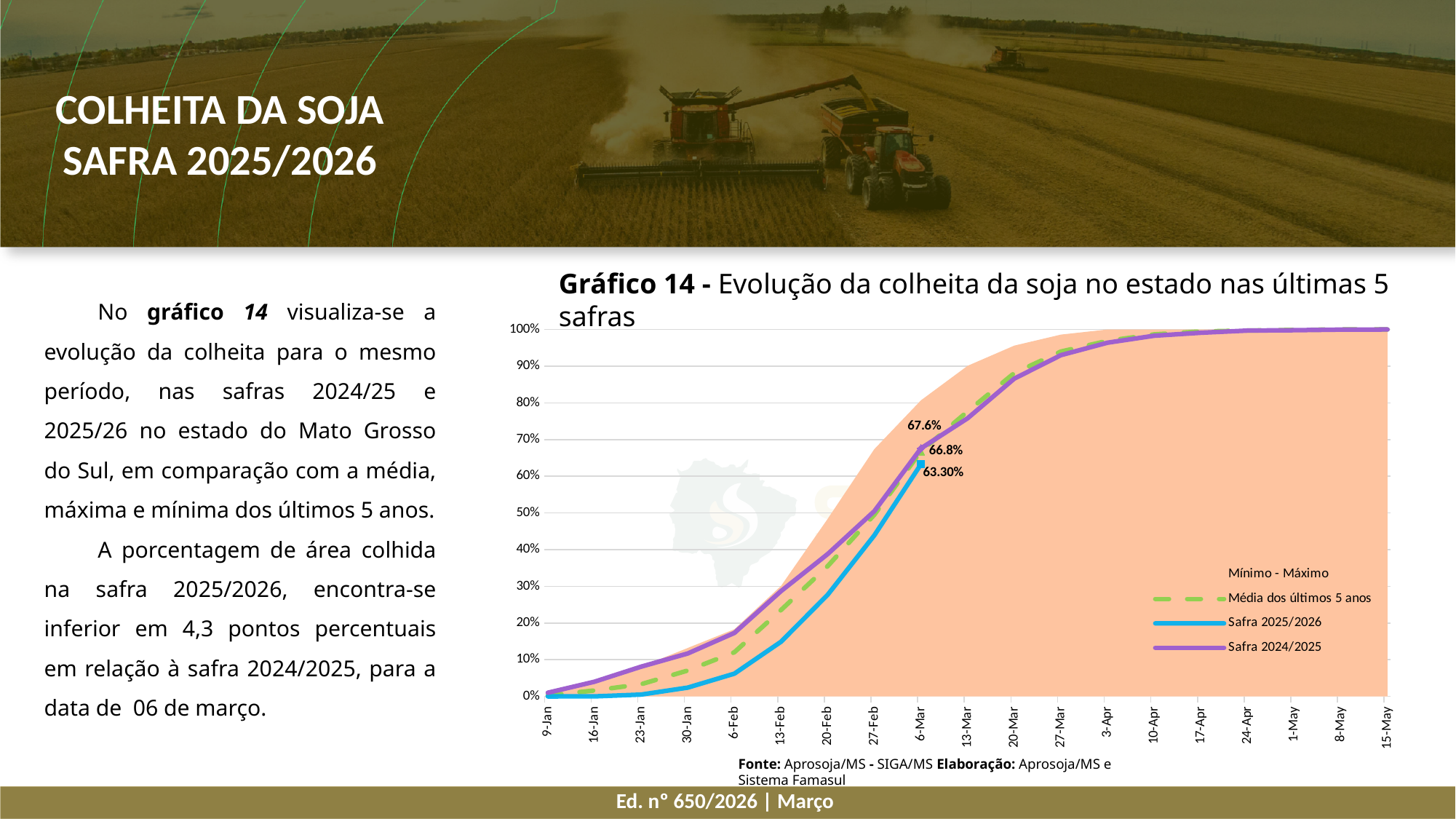
What is the value of Média dos últimos 5 anos on 6-Mar? 66.8% How many date labels are shown on the x axis? 19 Is the value for Safra 2024/2025 on 20-Mar greater or less than 80%? greater How many entries does the legend list? 4 On 6-Mar, how many percentage points higher is Média dos últimos 5 anos than Safra 2025/2026? 3.5 percentage points What is the value of Safra 2025/2026 on 6-Mar? 63.30% What kind of chart is Gráfico 14? combination area and line chart Is the value for Safra 2025/2026 on 6-Feb greater or less than 10%? less Do the values for Safra 2025/2026 rise or fall from 9-Jan to 6-Mar? rise What is the value of Safra 2024/2025 on 6-Mar? 67.6% On 6-Mar, how many percentage points higher is Safra 2024/2025 than Safra 2025/2026? 4.3 percentage points On 6-Mar, which is higher: Safra 2024/2025 or Safra 2025/2026? Safra 2024/2025